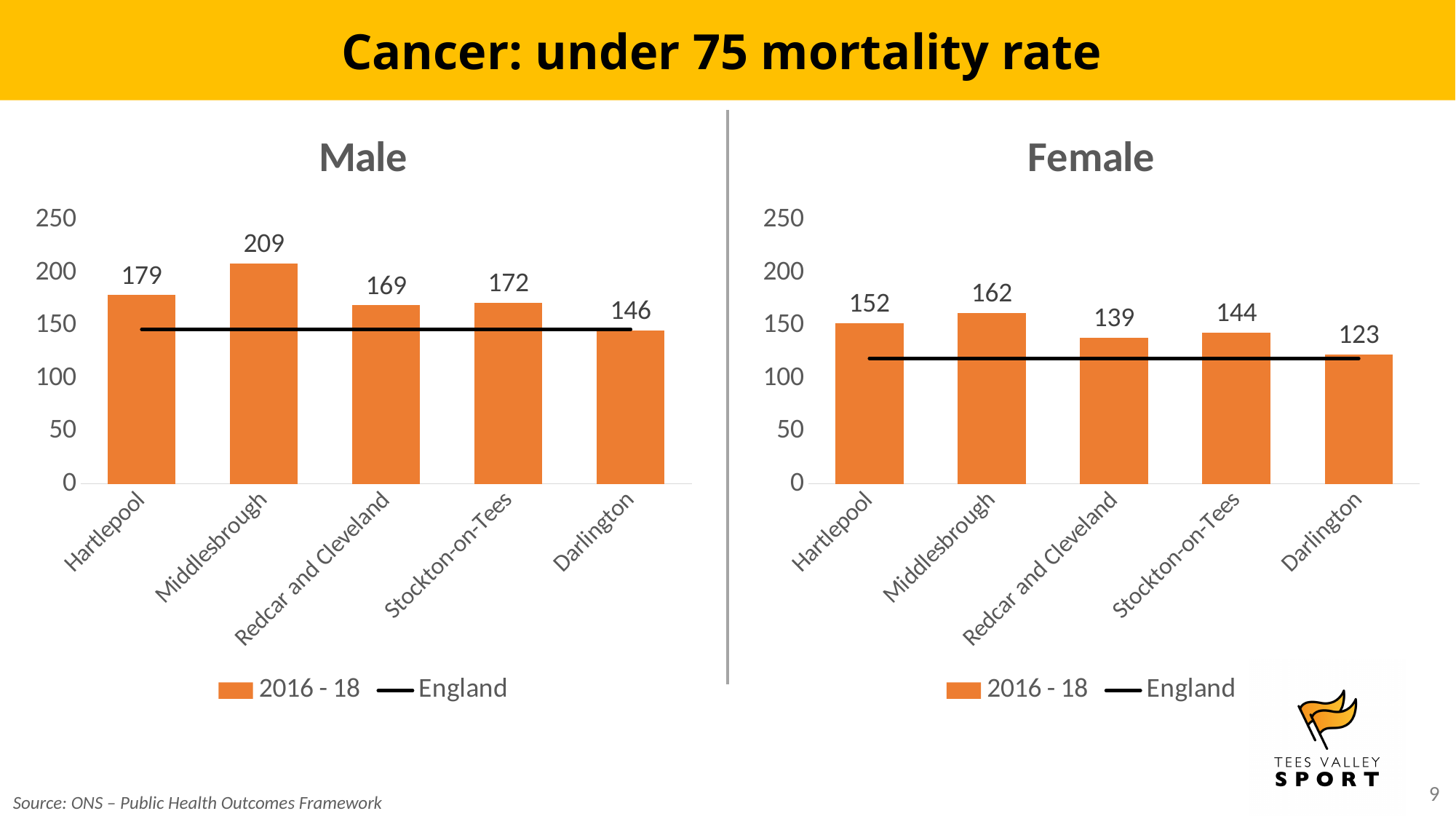
How many areas are shown in the Female chart? 5 How many entries does the legend of the Male chart list? 2 In the Male chart, what is the value for Middlesbrough? 209 What is the title of the chart on the right side of the slide? Female In the Male chart, what is the difference between Middlesbrough and Darlington? 63 What kind of chart is the Male chart? bar and line chart In the Female chart, which is larger, Middlesbrough or Hartlepool? Middlesbrough In the Female chart, what is the value for Redcar and Cleveland? 139 In the Male chart, which area has the highest value? Middlesbrough In the Male chart, is the England line greater or less than 150? less In the Female chart, what is the difference between Hartlepool and Stockton-on-Tees? 8 In the Female chart, which area has the lowest value? Darlington